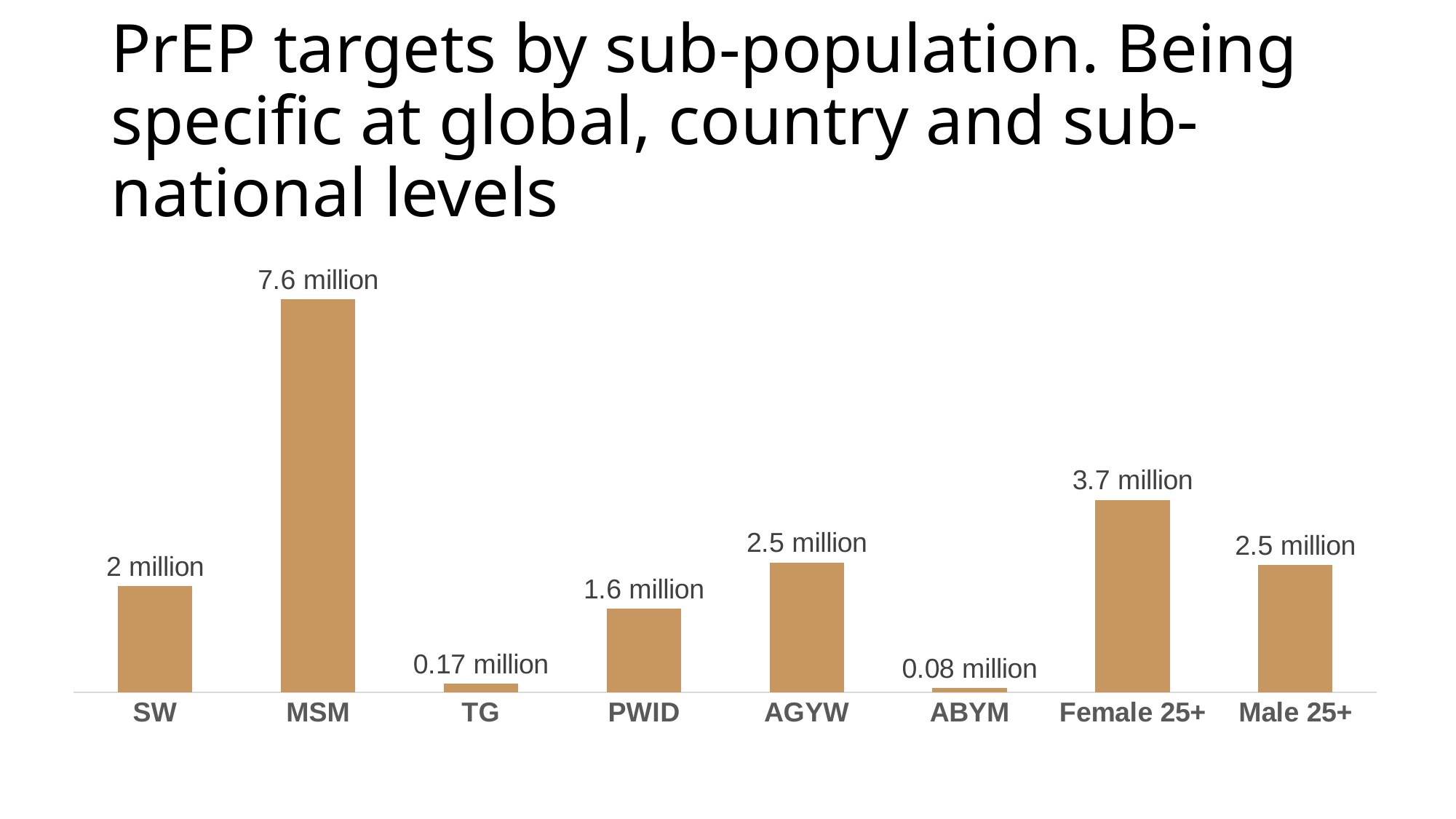
What is the PrEP target for ABYM? 0.08 million What is the PrEP target for Female 25+? 3.7 million What is the PrEP target for TG? 0.17 million How many sub-populations are shown in the chart? 8 Which sub-population has the highest PrEP target? MSM What is the difference between the PrEP targets for AGYW and PWID? 0.9 million What is the difference between the PrEP targets for MSM and Female 25+? 3.9 million What is the PrEP target for PWID? 1.6 million Which sub-population has the lowest PrEP target? ABYM Which has a larger PrEP target, SW or Female 25+? Female 25+ What kind of chart is shown on the slide? Bar chart What is the PrEP target for MSM? 7.6 million